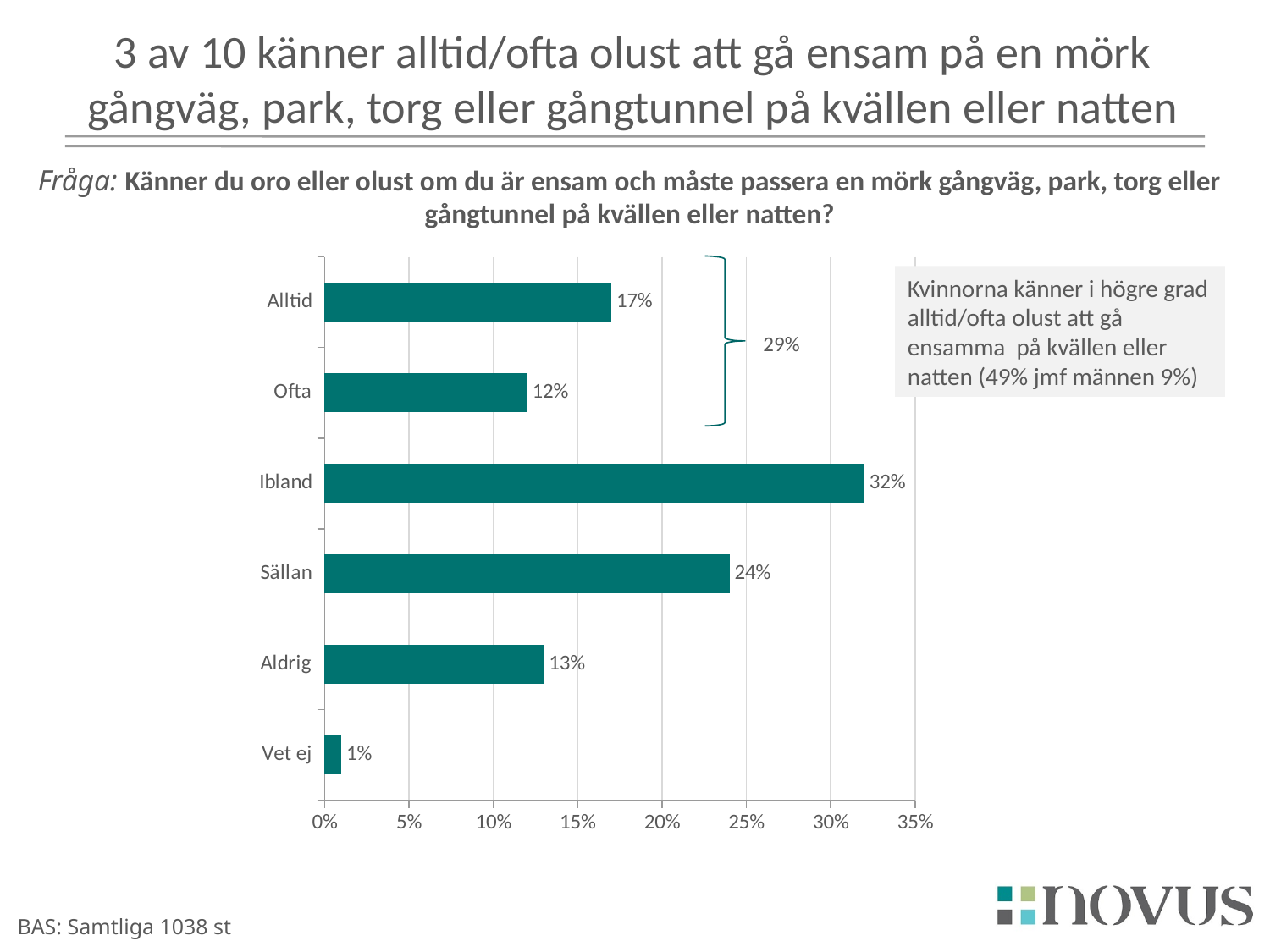
Which category has the highest value? Ibland What is the value for Alltid? 17% What is the value for Vet ej? 1% What combined value does the bracket next to Alltid and Ofta show? 29% Which category has the lowest value? Vet ej Which is larger, the value for Aldrig or the value for Ofta? Aldrig What is the value for Sällan? 24% What is the value for Ofta? 12% What kind of chart is shown on the slide? bar chart How many categories are shown on the chart? 6 What is the difference between the values for Ibland and Sällan? 8% Is the value for Sällan greater or less than 20%? greater